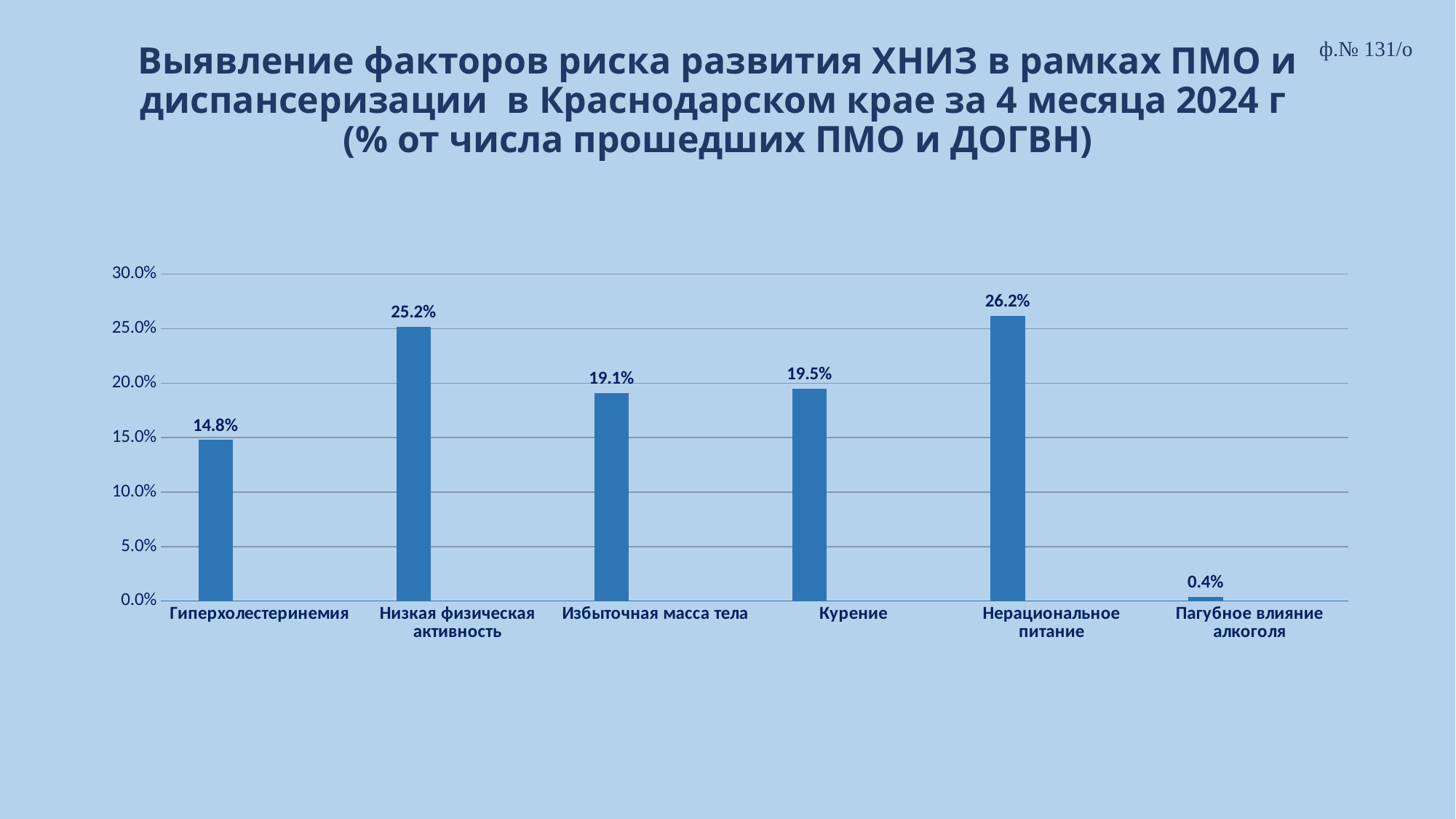
What kind of chart is shown on the slide? bar chart What is the value for Низкая физическая активность? 25.2% Which category has the highest value? Нерациональное питание Is the value for Низкая физическая активность greater or less than 20.0%? greater Which is larger, the value for Гиперхолестеринемия or the value for Избыточная масса тела? Избыточная масса тела What is the value for Пагубное влияние алкоголя? 0.4% Which category has the lowest value? Пагубное влияние алкоголя What is the value for Гиперхолестеринемия? 14.8% How many categories are shown on the chart? 6 What is the difference between the values for Курение and Избыточная масса тела? 0.4% What is the value for Курение? 19.5% What is the difference between the values for Нерациональное питание and Низкая физическая активность? 1.0%